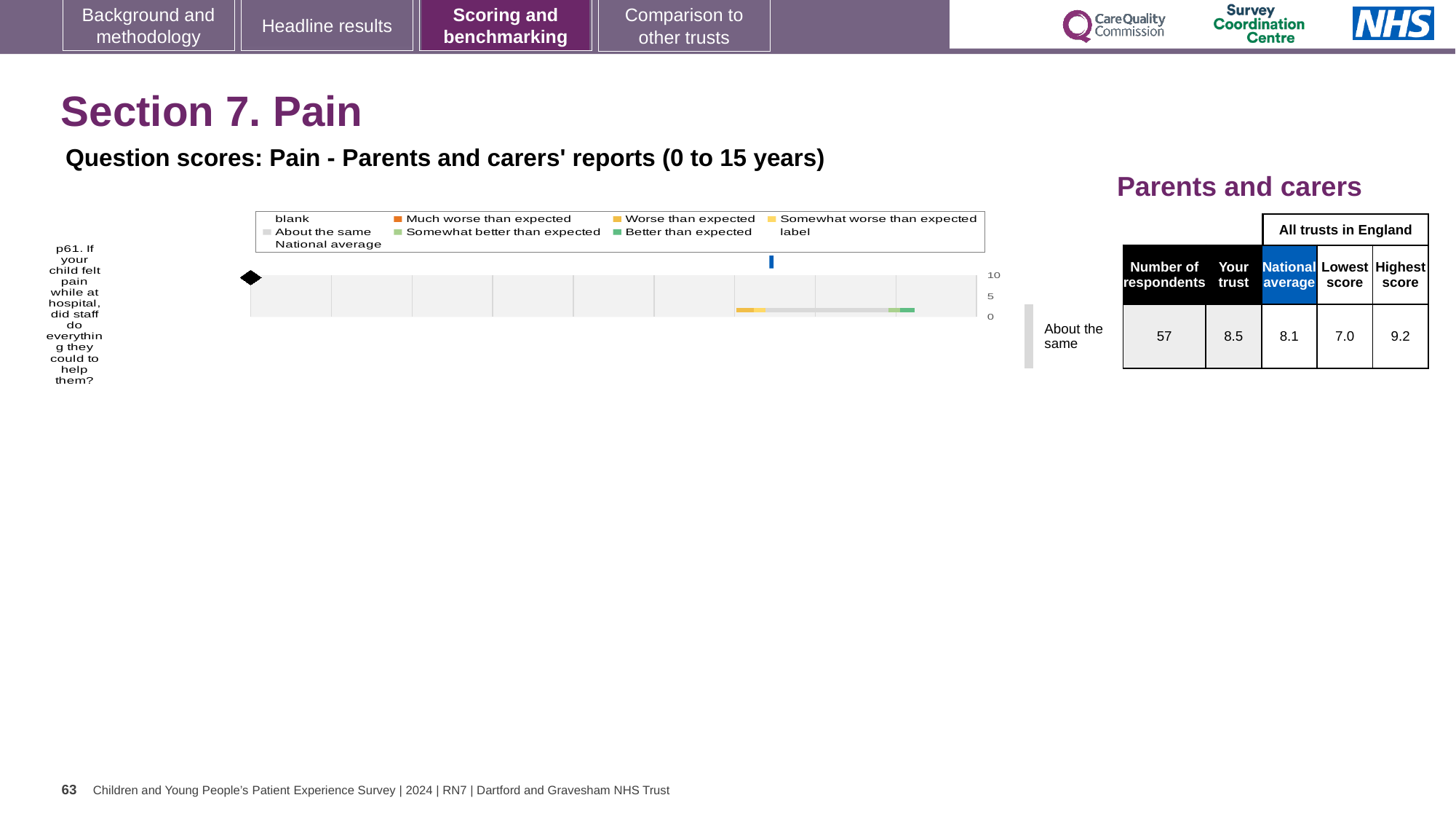
In the table, what is the 'Your trust' score for the question 'About the same'? 8.5 In the table, what is the lowest score among all trusts in England? 7.0 In the table, what is the highest score among all trusts in England? 9.2 How many survey questions are plotted in the chart? 1 What is the difference between the highest score and the lowest score in the table? 2.2 Is the national average marker on the chart greater or less than 5? greater What kind of chart is shown on the slide? bar chart Which is larger in the table, the 'Your trust' score or the national average? Your trust In the table, what is the national average score? 8.1 What is the highest value shown on the chart's score axis? 10 In the table, how many respondents are listed? 57 What colour does the legend use for 'Much worse than expected'? orange